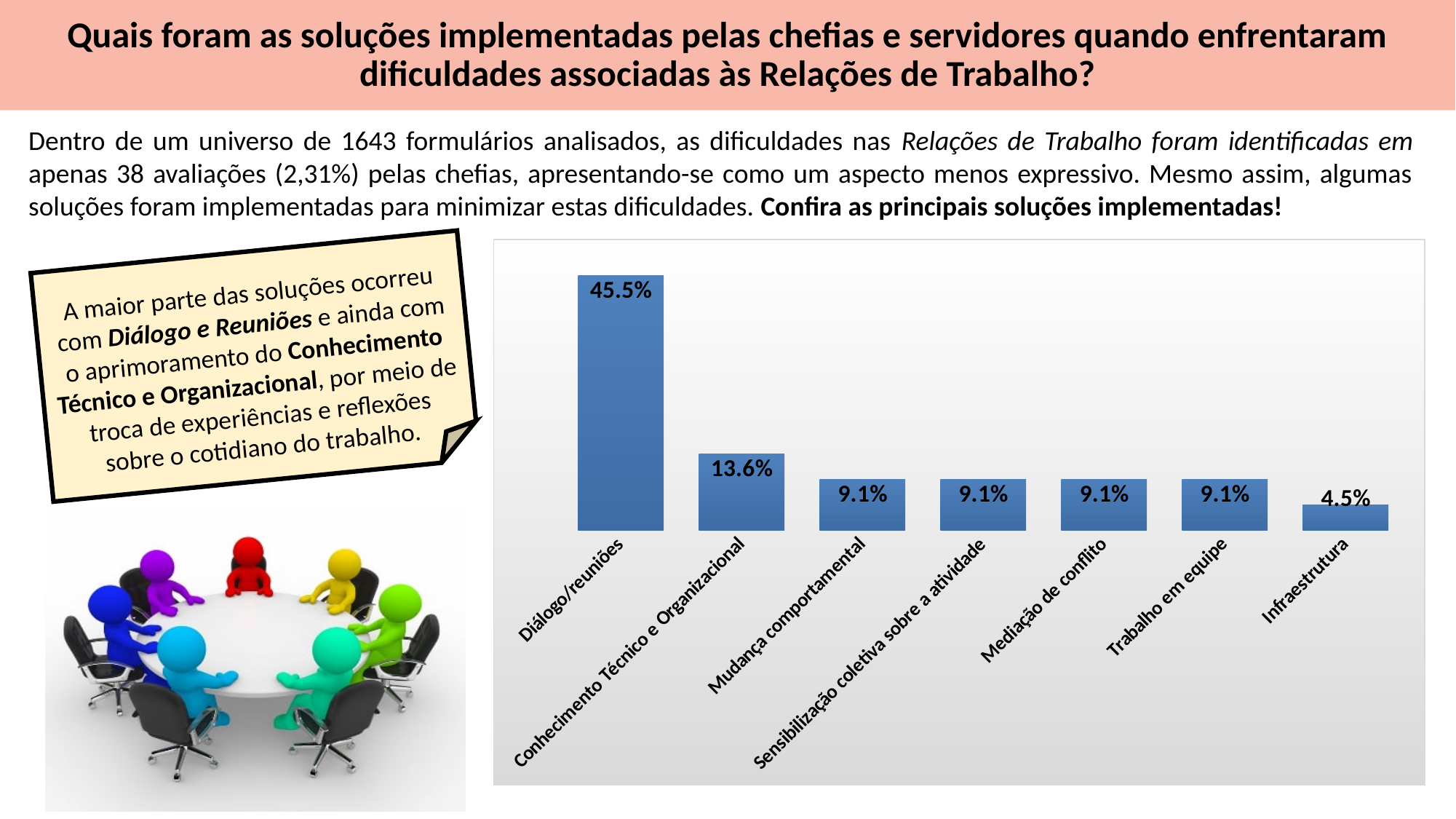
How many categories are shown in the chart? 7 What is the value for Conhecimento Técnico e Organizacional? 13.6% What is the value for Mediação de conflito? 9.1% What is the value for Infraestrutura? 4.5% What is the difference between the values for Diálogo/reuniões and Conhecimento Técnico e Organizacional? 31.9% Which category has the lowest value? Infraestrutura How many categories share the value 9.1%? 4 What kind of chart is shown on the slide? Bar chart Which is larger, the value for Conhecimento Técnico e Organizacional or the value for Mudança comportamental? Conhecimento Técnico e Organizacional Which category has the highest value? Diálogo/reuniões What is the value for Diálogo/reuniões? 45.5% What is the difference between the values for Trabalho em equipe and Infraestrutura? 4.6%